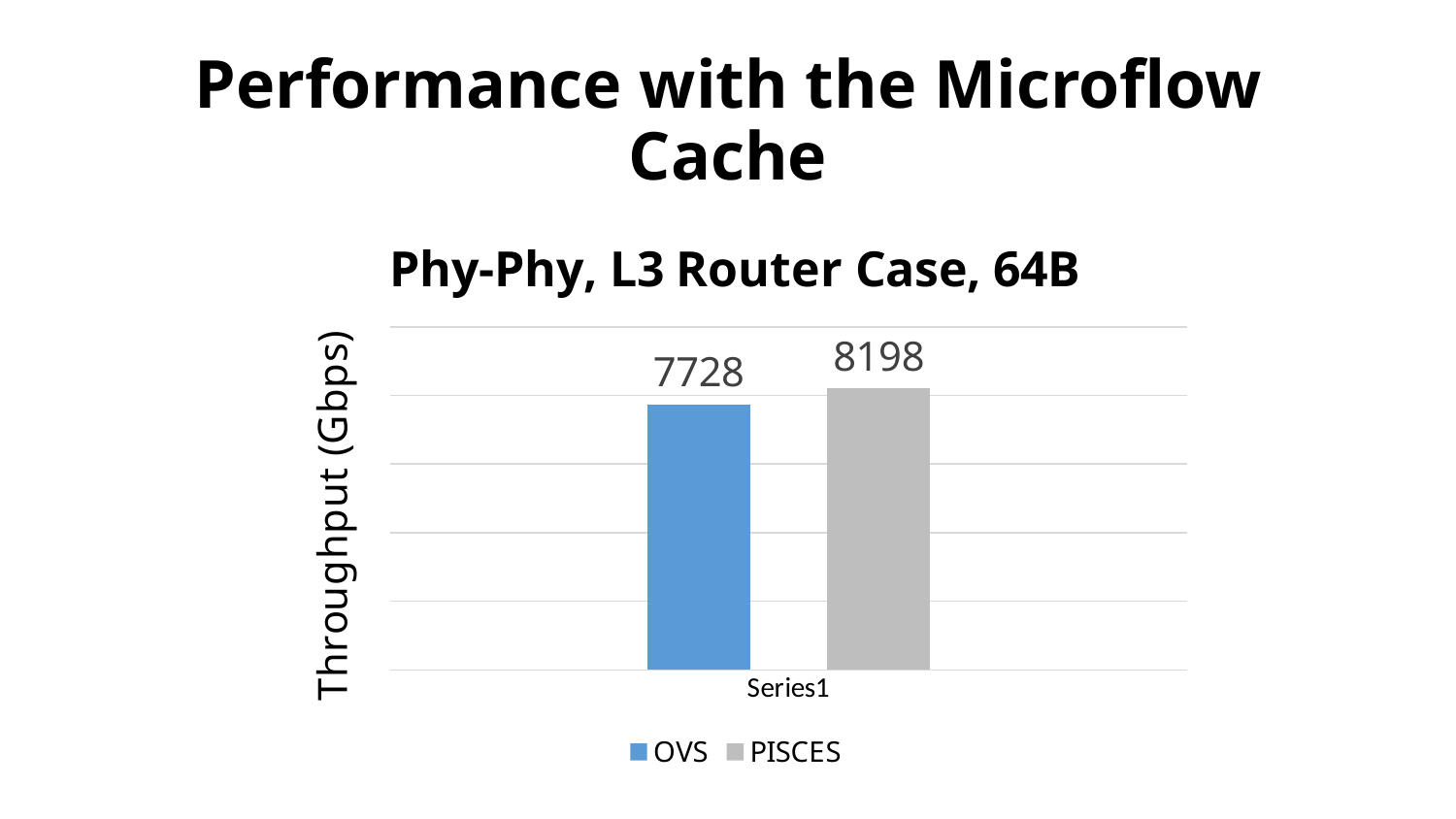
Which series has the highest throughput? PISCES Which series has the higher throughput, OVS or PISCES? PISCES What kind of chart is shown on the slide? Bar chart What is the throughput value for PISCES? 8198 What is the label on the vertical axis of the chart? Throughput (Gbps) What is the title of the chart? Phy-Phy, L3 Router Case, 64B What is the category label shown on the x axis? Series1 Which series has the lowest throughput? OVS How many series does the legend list? 2 What is the throughput value for OVS? 7728 What is the difference in throughput between PISCES and OVS? 470